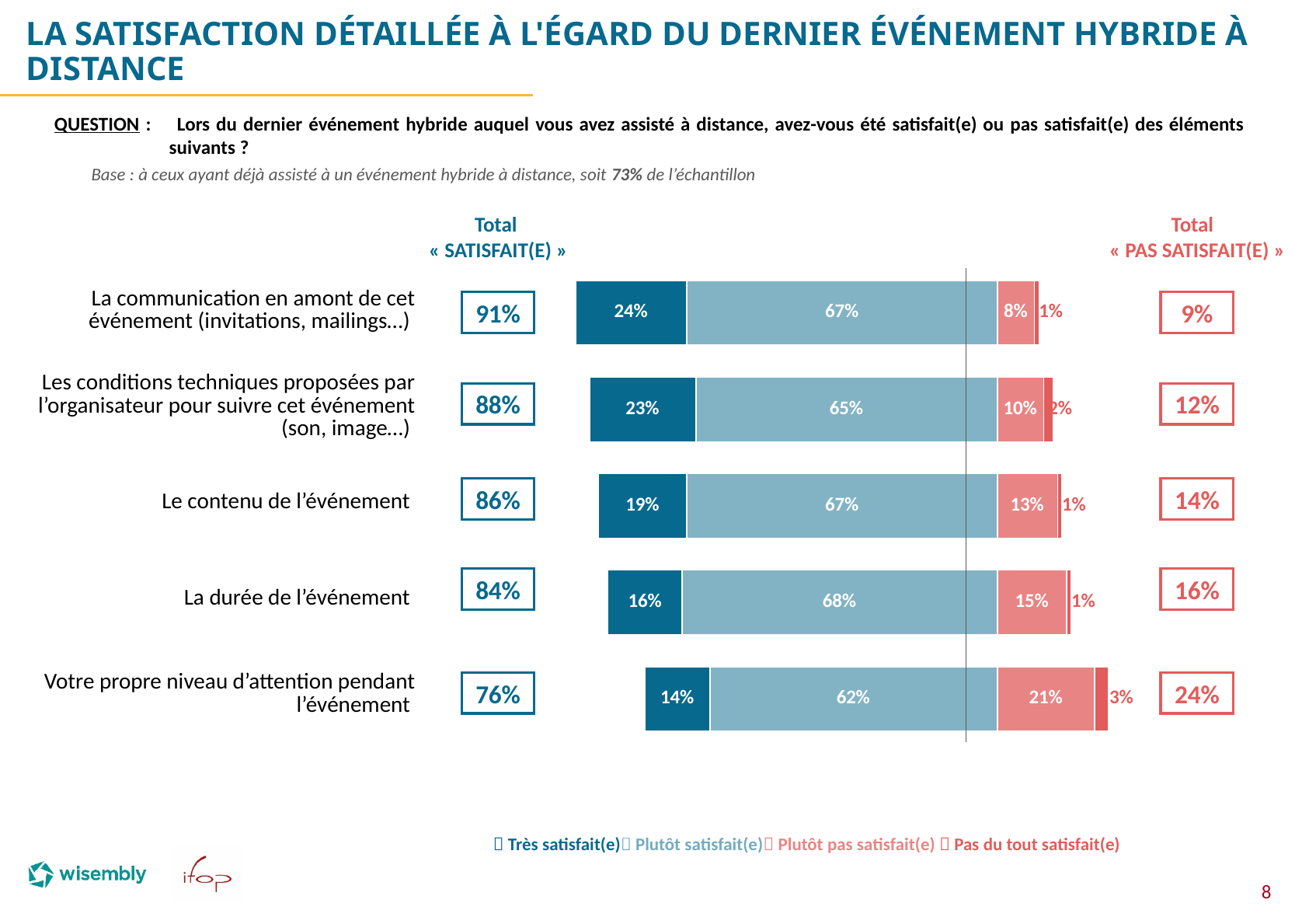
What is the difference between the Total « SATISFAIT(E) » values for 'La communication en amont de cet événement' and 'Le contenu de l'événement'? 5% What is the 'Plutôt satisfait(e)' value for 'La durée de l'événement'? 68% What type of chart is shown on the slide? Stacked bar chart Which is larger: the 'Plutôt pas satisfait(e)' value for 'Le contenu de l'événement' or for 'La durée de l'événement'? La durée de l'événement What is the 'Pas du tout satisfait(e)' value for 'Les conditions techniques proposées par l'organisateur pour suivre cet événement (son, image…)'? 2% Which item has the lowest 'Très satisfait(e)' value? Votre propre niveau d'attention pendant l'événement Which item has the highest Total « PAS SATISFAIT(E) » value? Votre propre niveau d'attention pendant l'événement What is the Total « SATISFAIT(E) » value for 'Les conditions techniques proposées par l'organisateur pour suivre cet événement (son, image…)'? 88% How many categories (items) are plotted in the chart? 5 What is the 'Très satisfait(e)' value for 'La communication en amont de cet événement (invitations, mailings…)'? 24% What is the 'Plutôt pas satisfait(e)' value for 'Votre propre niveau d'attention pendant l'événement'? 21% How many series does the legend list? 4